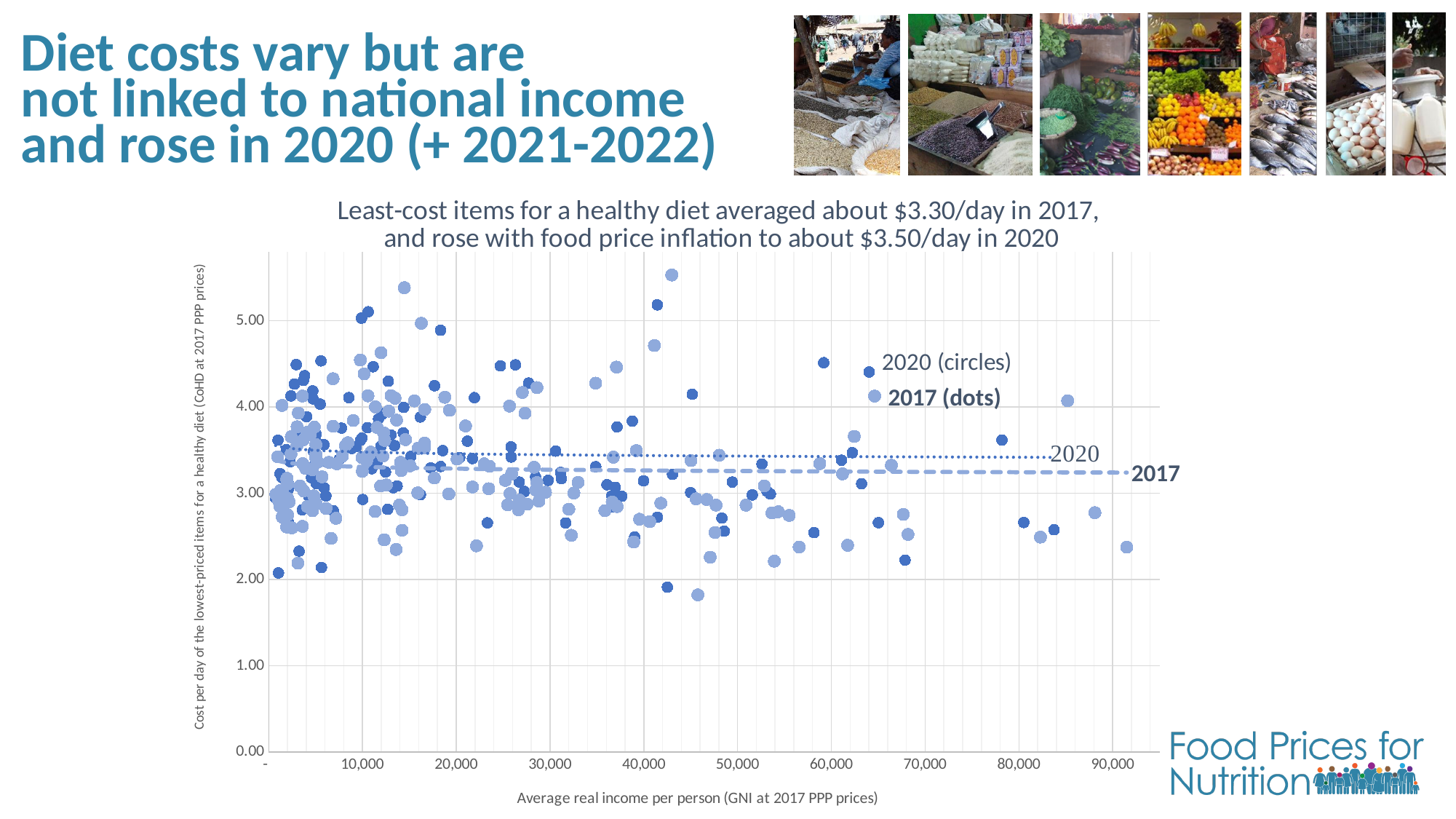
Is the 2020 trend line greater or less than 4.00 on the y axis? less According to the legend, which year is shown as circles? 2020 Is the 2017 trend line greater or less than 3.00 on the y axis? greater According to the chart title, what was the average cost per day of least-cost items for a healthy diet in 2020? About $3.50/day According to the chart title, what was the average cost per day of least-cost items for a healthy diet in 2017? About $3.30/day Is the lowest plotted diet cost on the chart greater or less than 2.00? less Do the trend lines for 2017 and 2020 rise, fall, or stay roughly flat as income increases along the x axis? Roughly flat What kind of chart is shown on the slide? Scatter chart Which two years are plotted in the chart? 2020 and 2017 How many data series does the chart's legend list? 2 Which year's average trend line sits higher on the chart, 2020 or 2017? 2020